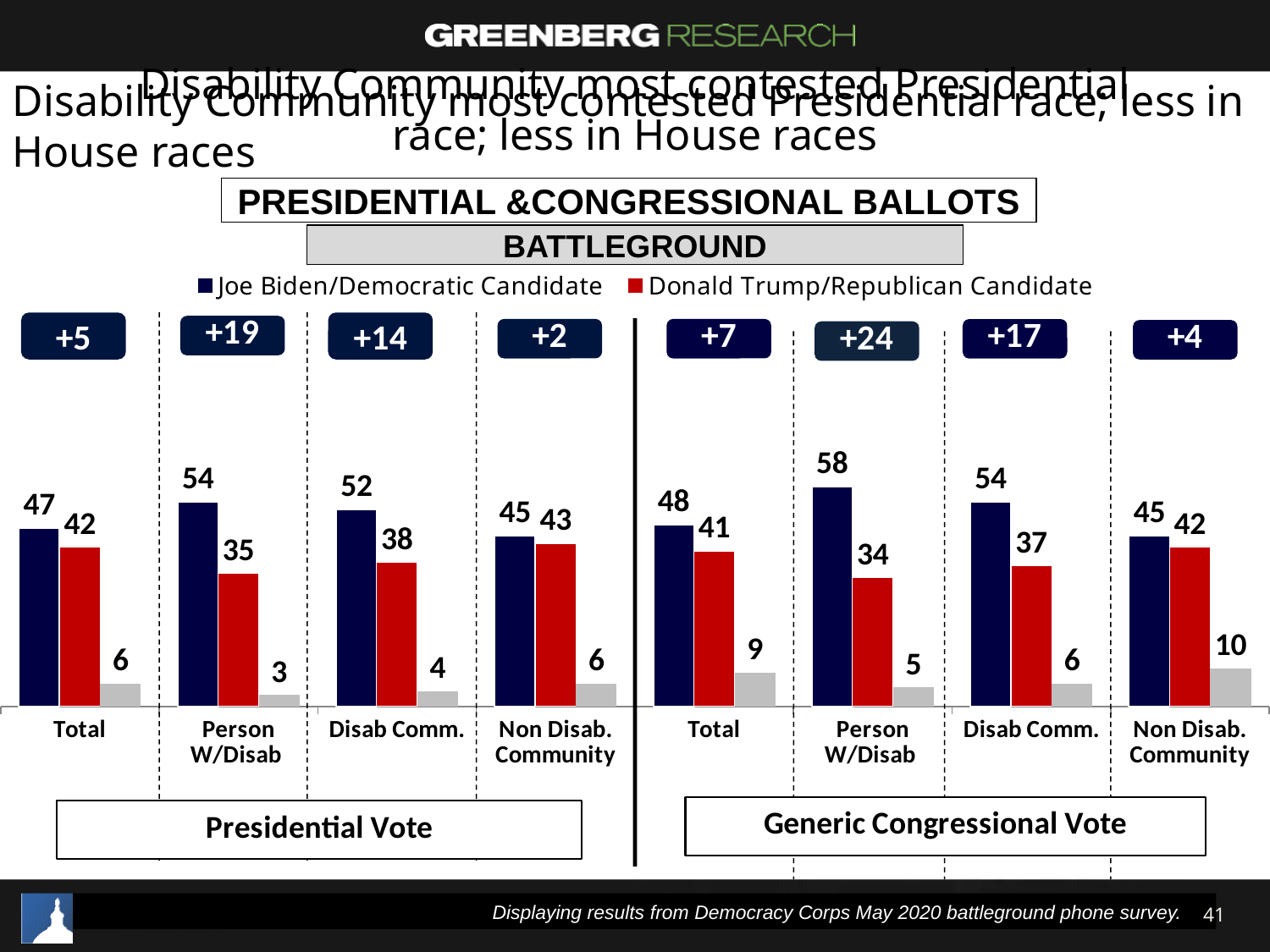
In the Presidential Vote section, what is the value for Joe Biden/Democratic Candidate among Person W/Disab? 54 In the Presidential Vote section, which category has the lowest Donald Trump/Republican Candidate value? Person W/Disab How many categories are shown on the x axis in total across both sections? 8 What kind of chart is shown on the slide? Bar chart In the Presidential Vote section, what is the value for Donald Trump/Republican Candidate in the Total category? 42 Is the Joe Biden/Democratic Candidate value for Non Disab. Community larger in the Presidential Vote section or the Generic Congressional Vote section, or are they equal? Equal (45 in both) How many series does the legend list? 2 In the Generic Congressional Vote section, what is the value for Joe Biden/Democratic Candidate among Disab Comm.? 54 In the Presidential Vote section, what is the difference between the Joe Biden/Democratic Candidate and Donald Trump/Republican Candidate values for Disab Comm.? 14 Across both sections, which category has the highest Joe Biden/Democratic Candidate value? Person W/Disab (Generic Congressional Vote) In the Generic Congressional Vote section, what is the difference between the Joe Biden/Democratic Candidate and Donald Trump/Republican Candidate values in the Total category? 7 In the Generic Congressional Vote section, what is the value for Donald Trump/Republican Candidate among Person W/Disab? 34